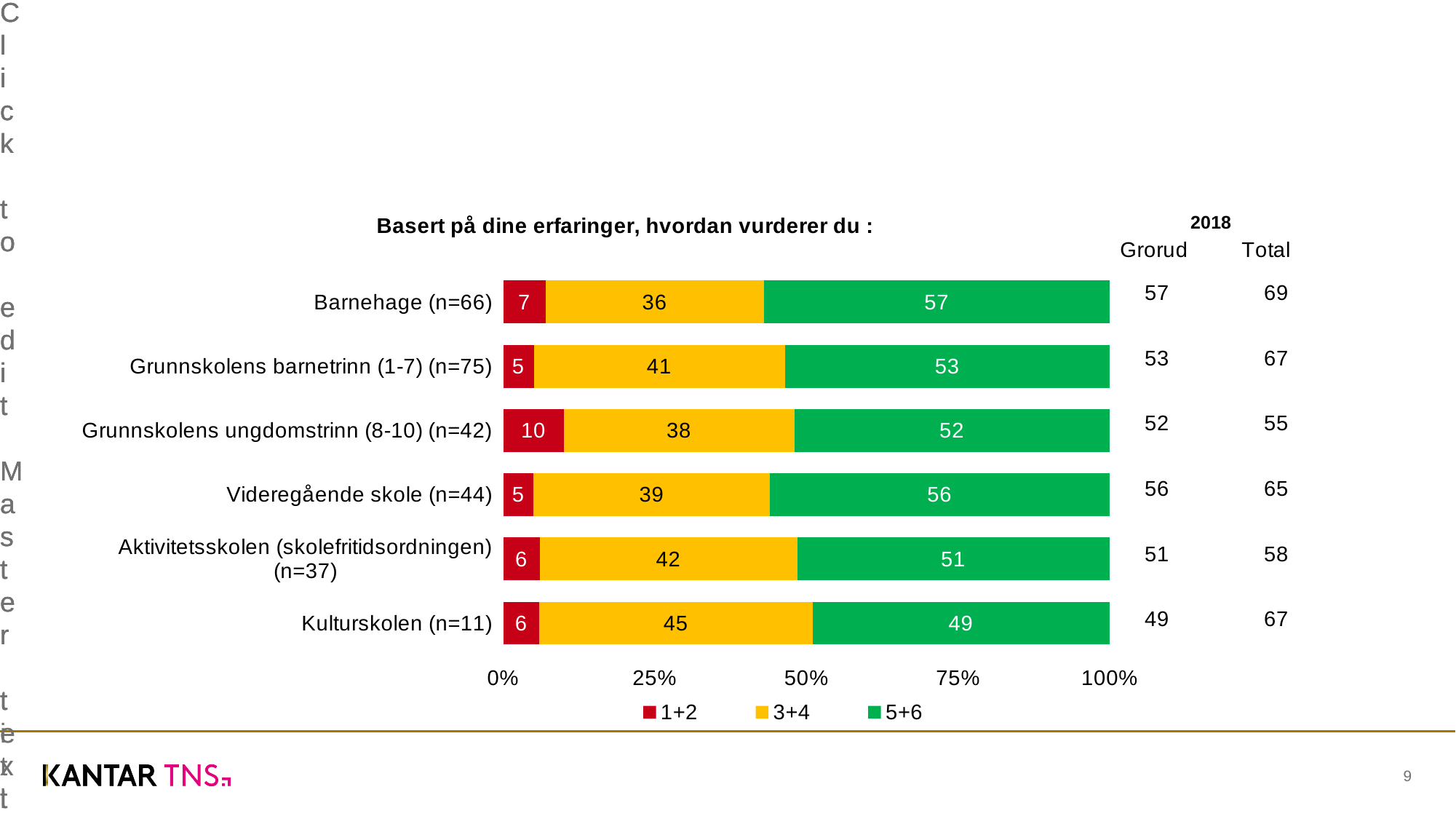
Which category has the lowest value in the 5+6 series? Kulturskolen (n=11) What is the value of the 5+6 series for Barnehage (n=66)? 57 How many categories are shown in the chart? 6 How many series does the legend list? 3 What is the difference between the 5+6 values for Barnehage (n=66) and Kulturskolen (n=11)? 8 What is the title of the chart? Basert på dine erfaringer, hvordan vurderer du : What is the total of the stacked bar for Videregående skole (n=44)? 100 What is the value of the 1+2 series for Grunnskolens ungdomstrinn (8-10) (n=42)? 10 Which is larger: the 3+4 value for Aktivitetsskolen (skolefritidsordningen) (n=37) or for Barnehage (n=66)? Aktivitetsskolen (skolefritidsordningen) (n=37) Which category has the highest value in the 1+2 series? Grunnskolens ungdomstrinn (8-10) (n=42) What is the value of the 3+4 series for Kulturskolen (n=11)? 45 What kind of chart is shown on the slide? Stacked bar chart